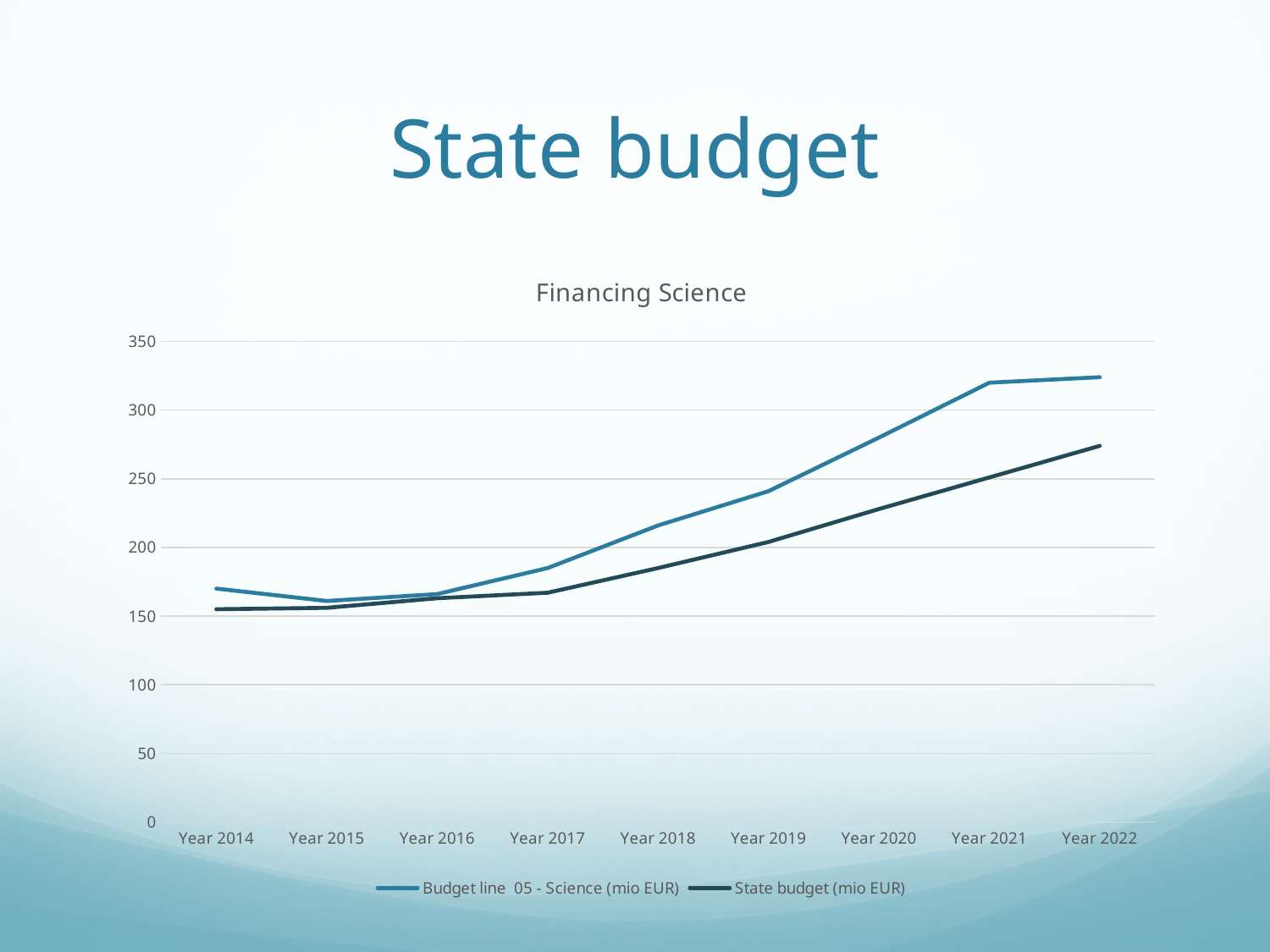
Is the value for State budget (mio EUR) in Year 2017 greater or less than 200? less Which year has the highest value for State budget (mio EUR)? Year 2022 Is the value for Budget line 05 - Science (mio EUR) in Year 2021 greater or less than 300? greater In Year 2020, which series has the larger value: Budget line 05 - Science (mio EUR) or State budget (mio EUR)? Budget line 05 - Science (mio EUR) Which series is drawn with the darker line? State budget (mio EUR) What kind of chart is shown on the slide? line chart Is the value for Budget line 05 - Science (mio EUR) in Year 2018 greater or less than 200? greater Does the State budget (mio EUR) series generally rise or fall from Year 2014 to Year 2022? rise What is the title of the chart? Financing Science How many years are shown on the x axis? 9 How many series does the legend list? 2